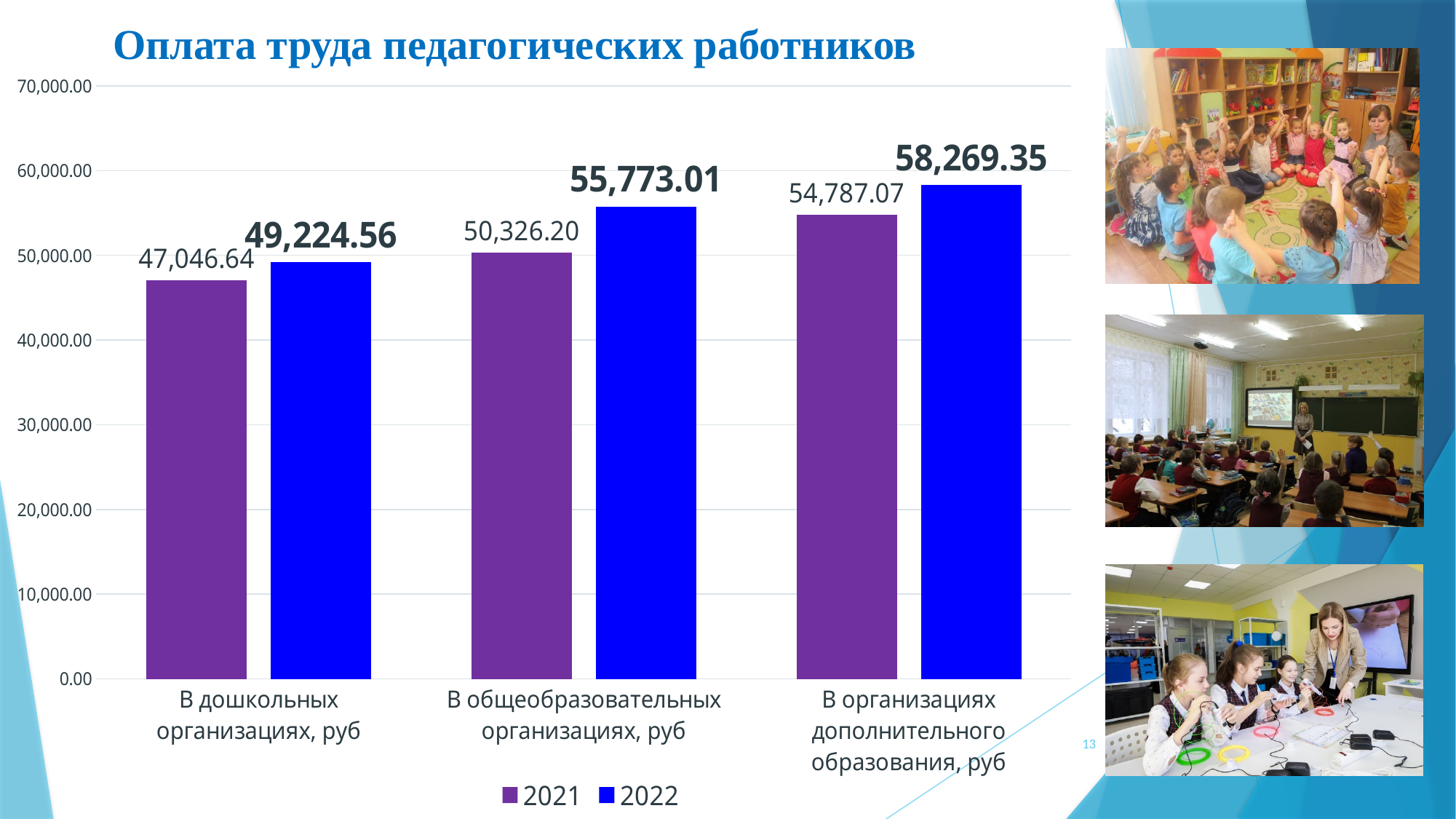
Which category has the lowest 2021 value? В дошкольных организациях, руб Is the 2022 value for «В организациях дополнительного образования, руб» greater or less than 60,000.00? less What is the 2021 value for «В организациях дополнительного образования, руб»? 54,787.07 What kind of chart is shown on the slide? bar chart How many series does the legend list? 2 What is the 2022 value for «В общеобразовательных организациях, руб»? 55,773.01 What is the difference between the 2022 and 2021 values for «В дошкольных организациях, руб»? 2,177.92 What is the 2021 value for «В дошкольных организациях, руб»? 47,046.64 Which category has the highest 2022 value? В организациях дополнительного образования, руб How many categories are shown on the x axis? 3 What is the difference between the 2022 and 2021 values for «В общеобразовательных организациях, руб»? 5,446.81 Which is larger: the 2022 value for «В дошкольных организациях, руб» or the 2021 value for «В общеобразовательных организациях, руб»? 2021 value for «В общеобразовательных организациях, руб»